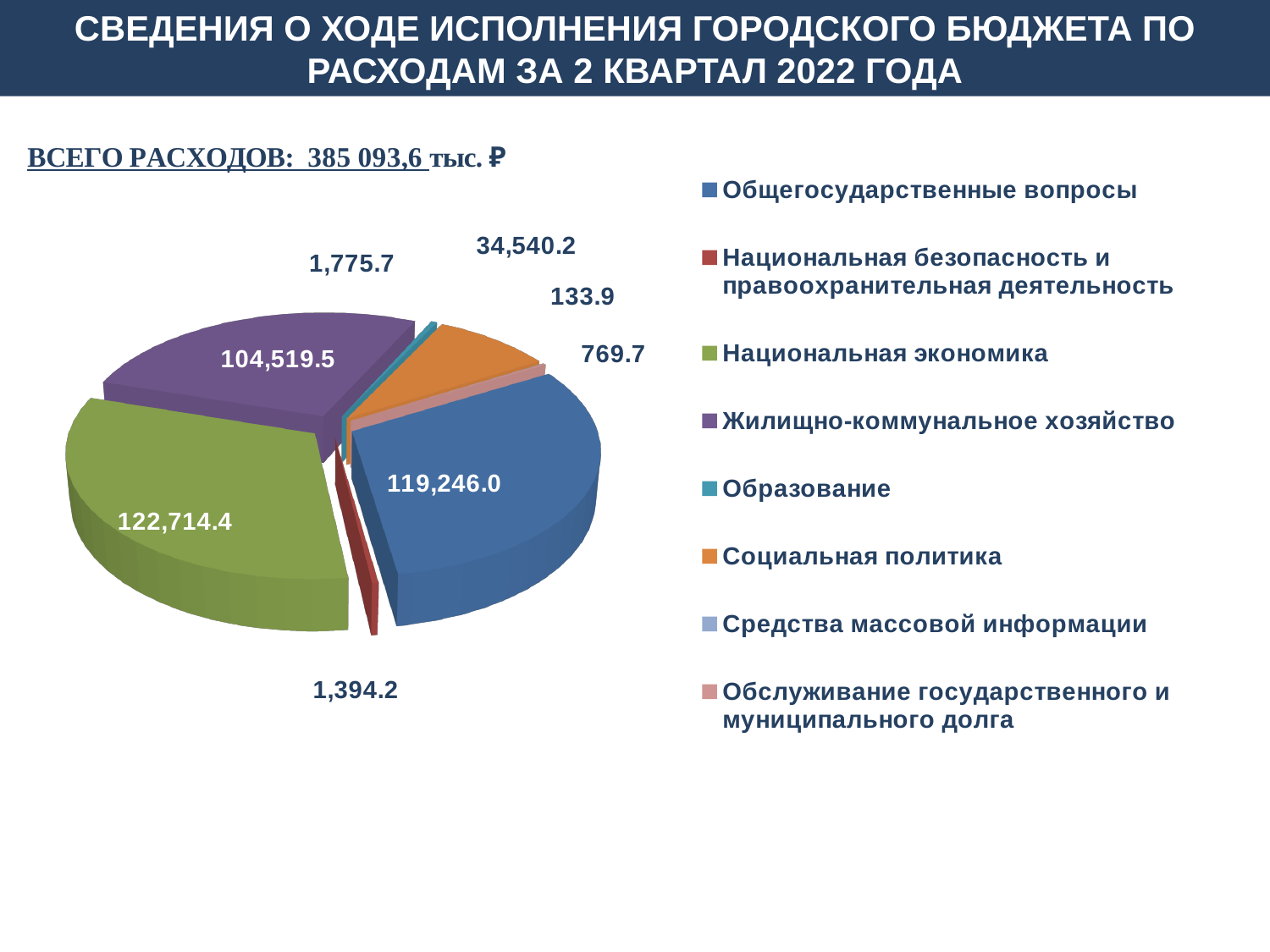
How many categories does the legend of the pie chart list? 8 What is the value for Национальная экономика? 122,714.4 What is the value for Социальная политика? 34,540.2 What is the value for Жилищно-коммунальное хозяйство? 104,519.5 What is the value for Общегосударственные вопросы? 119,246.0 What kind of chart is shown on the slide? Pie chart Which category has the smallest value? Средства массовой информации What is the value for Национальная безопасность и правоохранительная деятельность? 1,394.2 Which category has the largest slice of the pie? Национальная экономика Which is larger: Жилищно-коммунальное хозяйство or Социальная политика? Жилищно-коммунальное хозяйство What is the difference between the values for Национальная экономика and Общегосударственные вопросы? 3,468.4 What is the value for Образование? 1,775.7